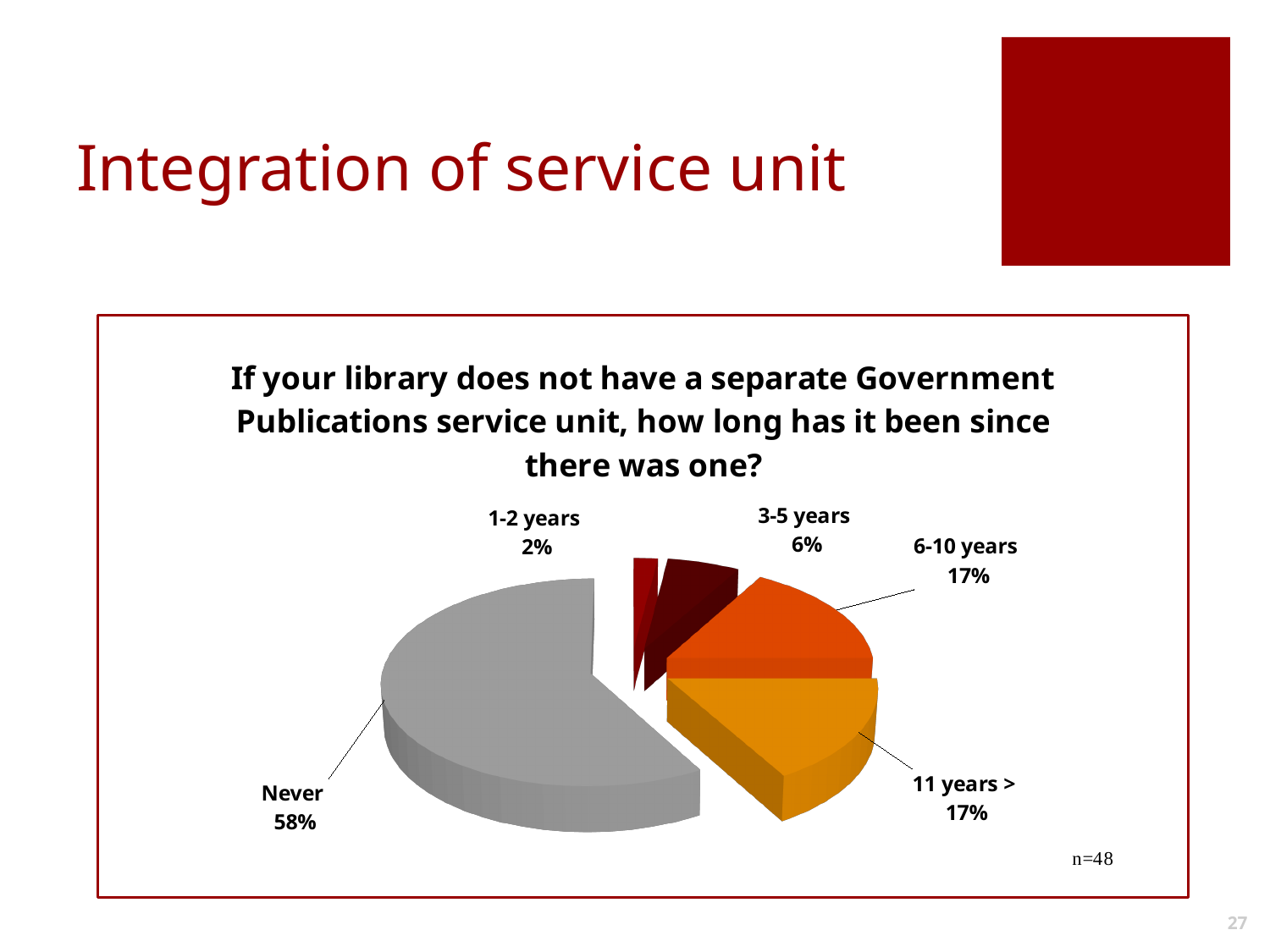
What percentage of the pie is labelled "11 years >"? 17% Which category has the largest share of the pie? Never What is the difference in percentage points between the "Never" slice and the "6-10 years" slice? 41 What sample size (n) is noted on the chart? n=48 What percentage of the pie is labelled "6-10 years"? 17% What percentage of the pie is labelled "Never"? 58% What percentage of the pie is labelled "1-2 years"? 2% What percentage of the pie is labelled "3-5 years"? 6% What kind of chart is shown on the slide? Pie chart Which category has the smallest share of the pie? 1-2 years How many categories are shown in the pie chart? 5 Which is larger, the "3-5 years" slice or the "1-2 years" slice? 3-5 years